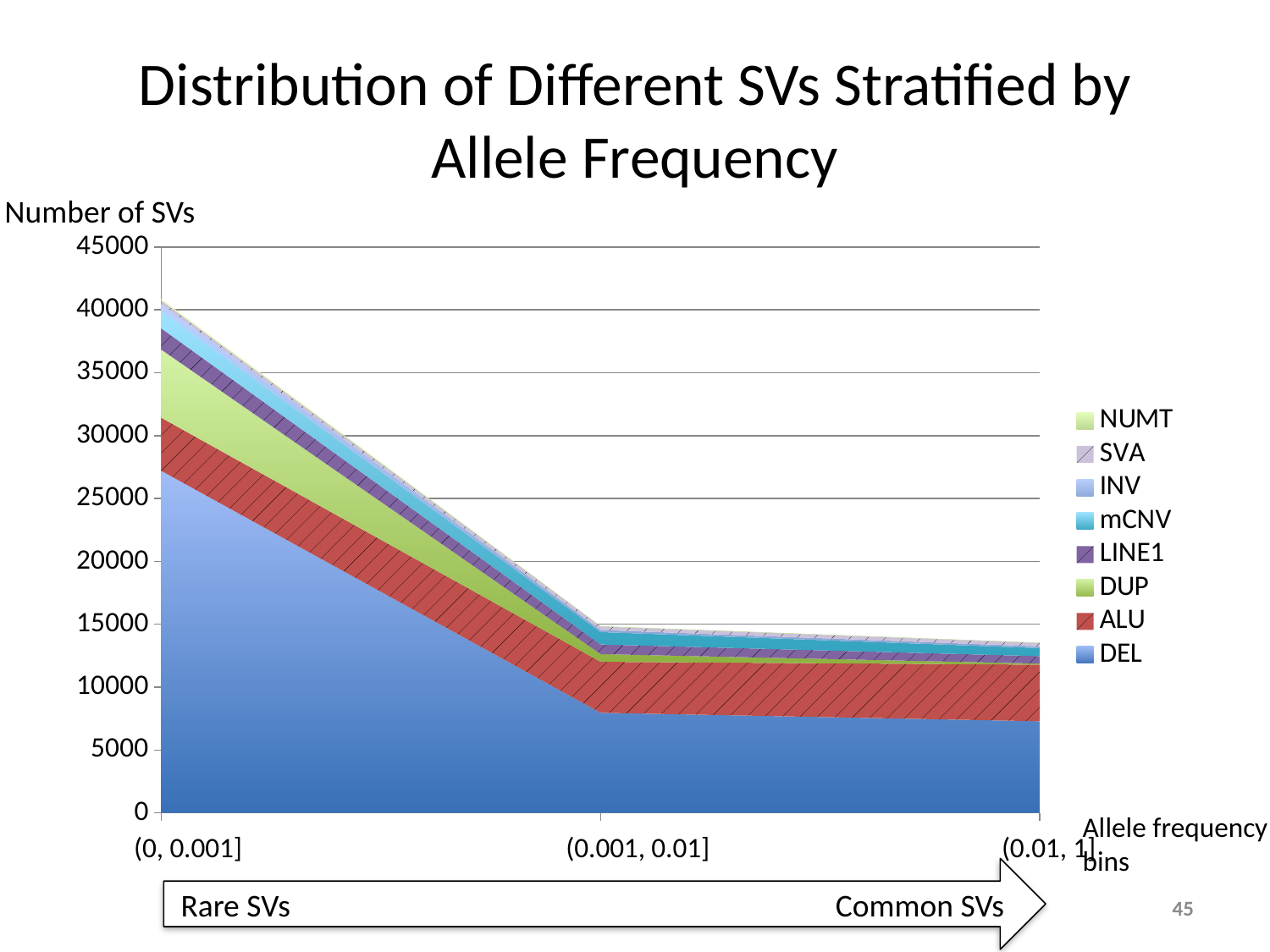
Which bin has more DEL SVs, (0, 0.001] or (0.01, 1]? (0, 0.001] Is the total number of SVs in the (0, 0.001] bin greater or less than 35000? greater Is the number of DEL SVs in the (0, 0.001] bin greater or less than 25000? greater Which allele frequency bin has the lowest total number of SVs? (0.01, 1] Does the total number of SVs rise or fall from the (0, 0.001] bin to the (0.01, 1] bin? Fall How many allele frequency bins are shown on the x axis? 3 Is the number of DEL SVs in the (0.01, 1] bin greater or less than 10000? less What kind of chart is shown on the slide? Stacked area chart What is the label of the vertical axis? Number of SVs How many series does the legend list? 8 Which allele frequency bin has the highest total number of SVs? (0, 0.001]